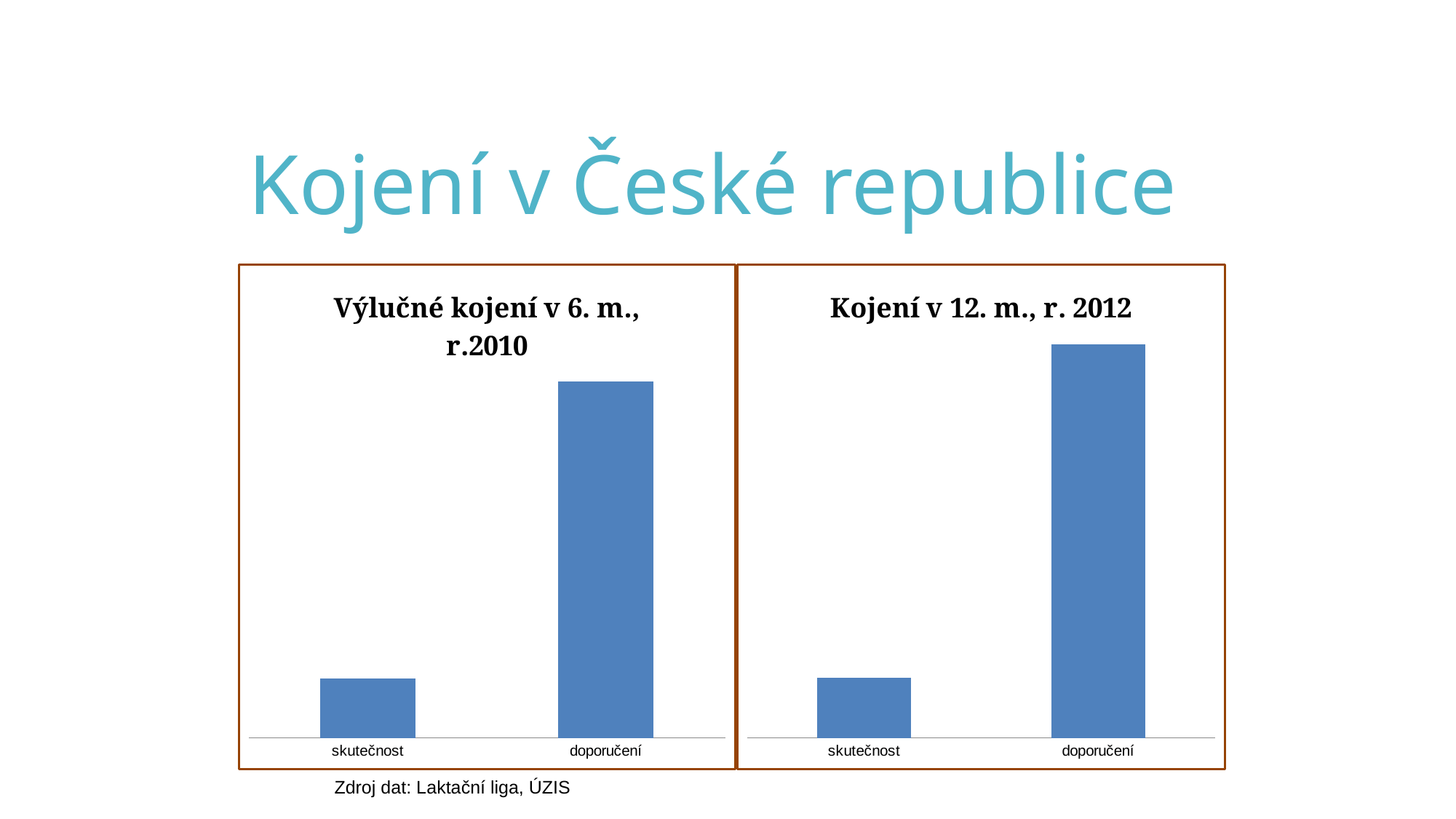
What kind of chart is the right chart on the slide? bar chart In the chart titled "Kojení v 12. m., r. 2012", which category has the lowest bar? skutečnost What is the title of the left chart? Výlučné kojení v 6. m., r.2010 What is the title of the right chart? Kojení v 12. m., r. 2012 In the right chart, is the bar for skutečnost or doporučení larger? doporučení In the left chart, is the bar for skutečnost or doporučení larger? doporučení In the chart titled "Výlučné kojení v 6. m., r.2010", which category has the lowest bar? skutečnost What kind of chart is the left chart on the slide? bar chart How many categories are shown in the chart titled "Kojení v 12. m., r. 2012"? 2 In the chart titled "Kojení v 12. m., r. 2012", which category has the highest bar? doporučení In the chart titled "Výlučné kojení v 6. m., r.2010", which category has the highest bar? doporučení How many categories are shown in the chart titled "Výlučné kojení v 6. m., r.2010"? 2